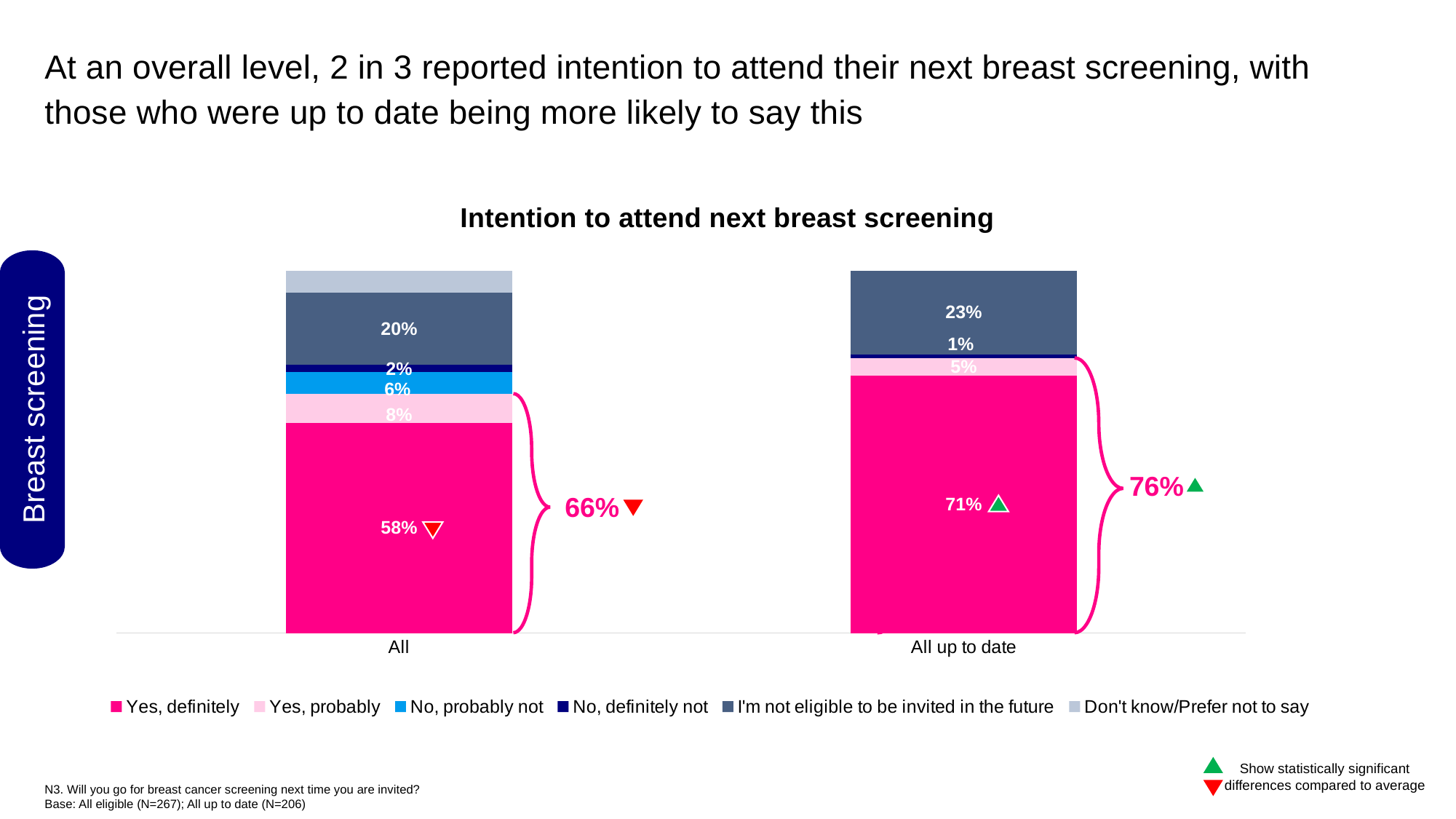
What is the difference between the bracketed combined 'Yes' totals for 'All up to date' (76%) and 'All' (66%)? 10 percentage points What is the combined 'Yes' percentage shown by the bracket for the 'All up to date' group? 76% How many response categories does the legend list? 6 What percentage of the 'All' group said 'Yes, probably'? 8% What type of chart is used to show intention to attend next breast screening? Stacked bar chart How many groups (bars) are shown on the chart? 2 What percentage of the 'All up to date' group said they are not eligible to be invited in the future? 23% What percentage of the 'All' group said 'No, probably not'? 6% What percentage of the 'All up to date' group said 'Yes, definitely'? 71% What percentage of the 'All' group said 'Yes, definitely' they would attend their next breast screening? 58% How many percentage points higher is 'Yes, definitely' for 'All up to date' than for 'All'? 13 Which group has the larger 'Yes, definitely' share, 'All' or 'All up to date'? All up to date